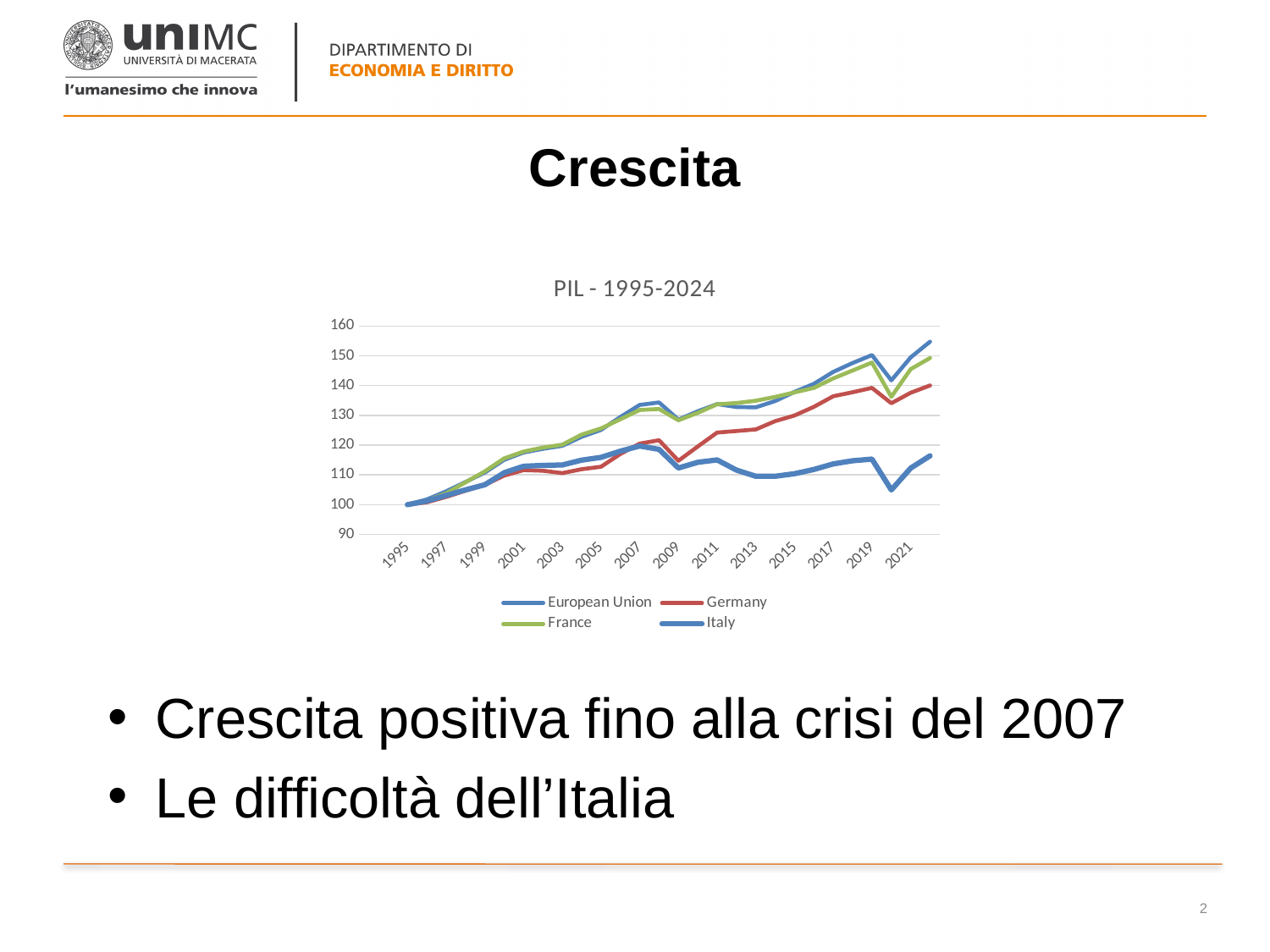
Does the Italy series rise or fall between 2007 and 2009? fall What kind of chart is shown on the slide? line chart Which series has the lowest value at the right end of the chart? Italy Is the value for Germany in 2009 greater or less than 120? less What is the title of the chart? PIL - 1995-2024 What value do all the series start at in 1995? 100 Which series has the highest value at the right end of the chart? European Union How many series does the chart's legend list? 4 Is the value for Italy in 2020 greater or less than 110? less Is the value for Germany in 2017 greater or less than 130? greater In 2019, which is higher, Germany or Italy? Germany